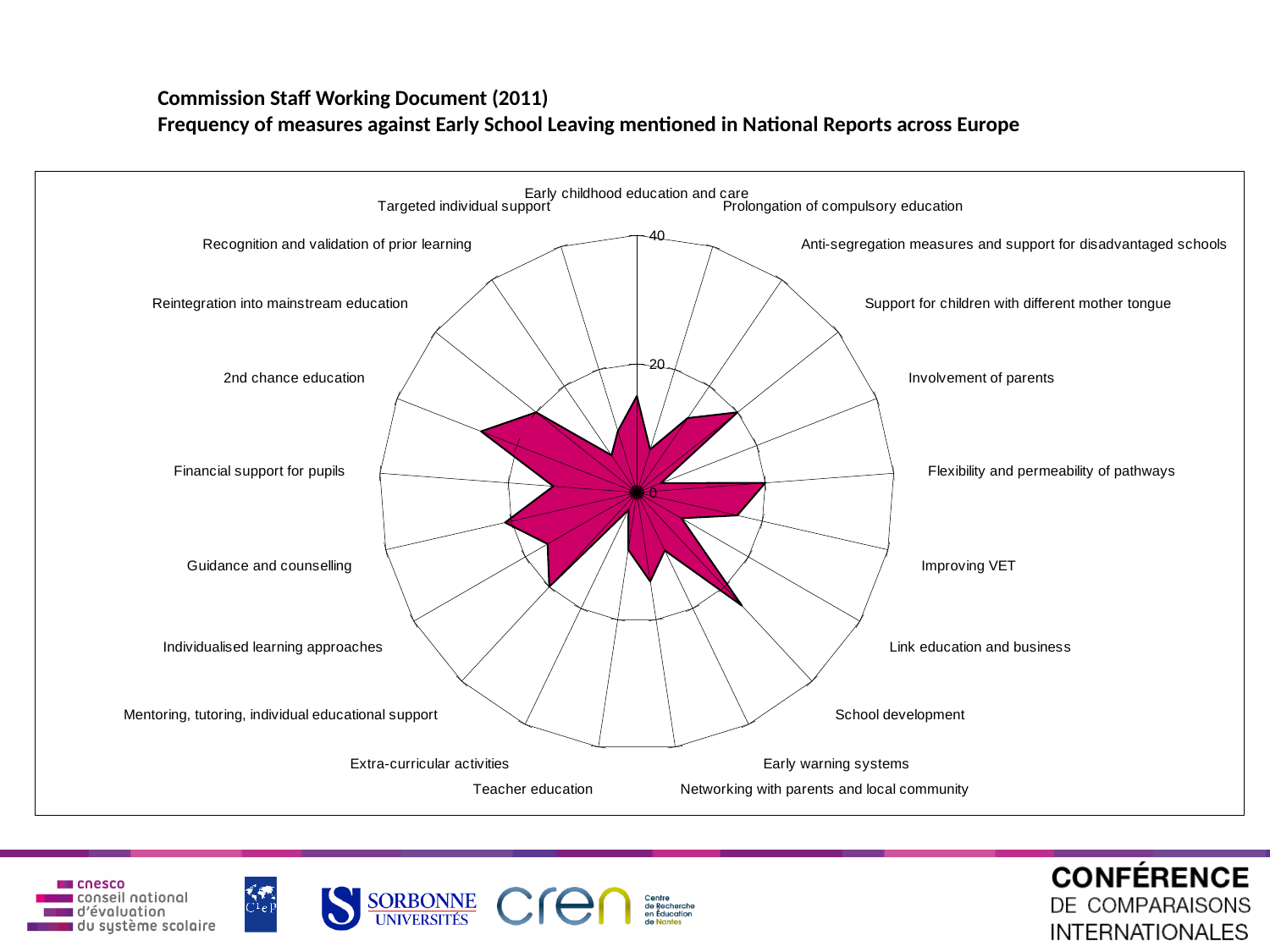
Is the value for 2nd chance education greater or less than 40? less How many measures (categories) are plotted on the radar chart? 21 Is the value for Prolongation of compulsory education greater or less than 20? less What kind of chart is shown on the slide? Radar chart Is the value for School development greater or less than 20? greater What is the highest tick value shown on the radar chart's axis? 40 According to the slide title, what does the chart show the frequency of? Measures against Early School Leaving mentioned in National Reports across Europe